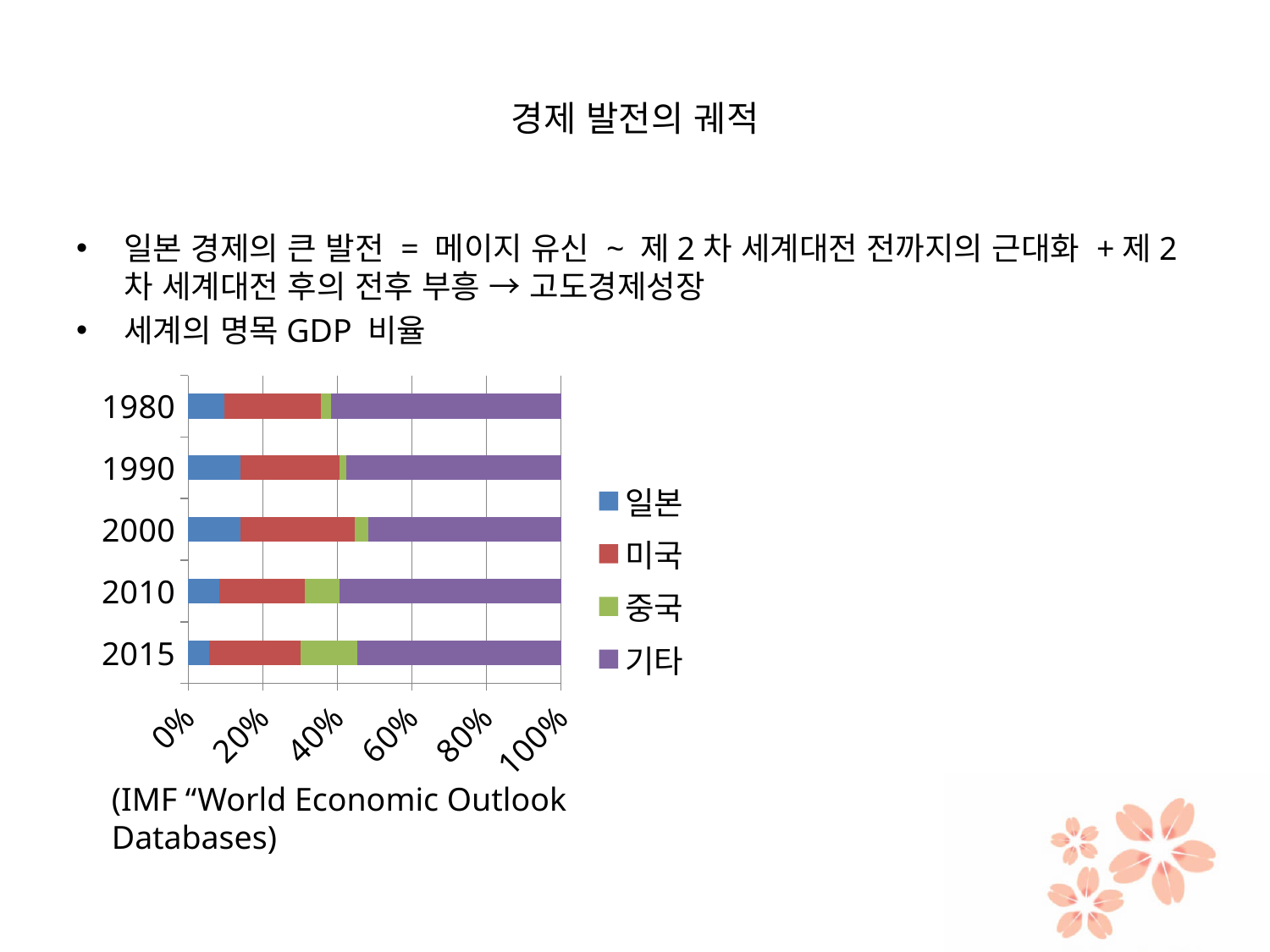
Does the share of 중국 rise or fall from 1980 to 2015? Rise Is the share of 미국 in 2000 greater or less than 20%? greater In 2015, which is larger, the share of 일본 or the share of 미국? 미국 What does each stacked bar total on the horizontal axis? 100% How many years are shown on the chart's vertical axis? 5 Which year is listed first (at the top) on the chart's vertical axis? 1980 In which year is the share of 중국 the largest? 2015 How many series does the chart legend list? 4 Is the share of 일본 in 2015 greater or less than 20%? less In which year is the share of 중국 the smallest? 1990 What are the legend entries of the chart? 일본, 미국, 중국, 기타 What kind of chart is shown on the slide? Stacked bar chart